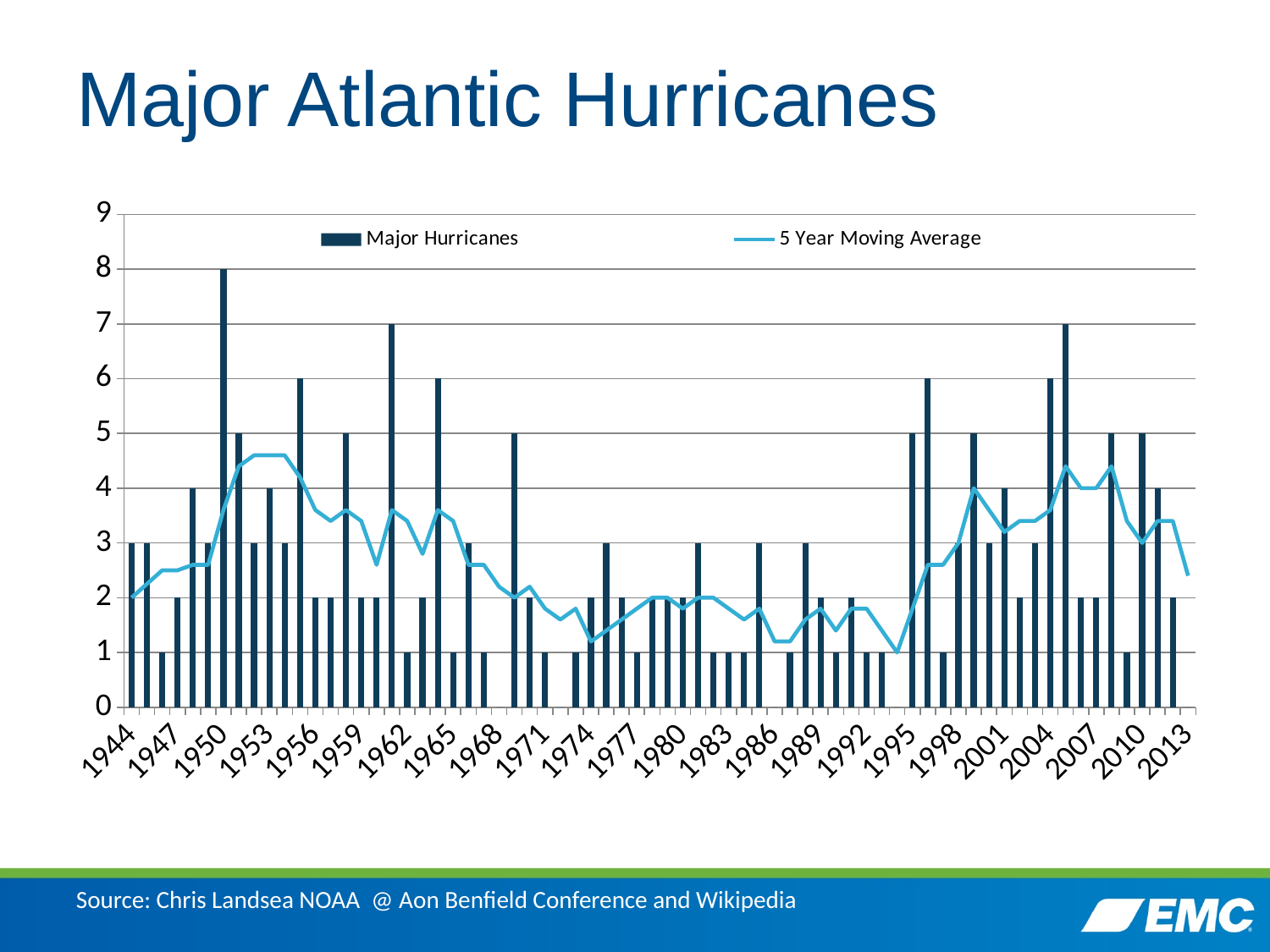
Which year has more major hurricanes, 1950 or 2004? 1950 How many major hurricanes are shown for 2004? 6 What is the difference between the number of major hurricanes in 1950 and in 2004? 2 Is the 5 Year Moving Average value for 1953 greater or less than 4? greater Is the 5 Year Moving Average value for 1986 greater or less than 2? less What kind of chart is shown on the slide? Bar chart with a line overlay How many major hurricanes are shown for 1995? 5 How many major hurricanes are shown for 1950? 8 How many series does the legend list? 2 Which year has the highest number of major hurricanes? 1950 What are the two series named in the legend? Major Hurricanes and 5 Year Moving Average Does the 5 Year Moving Average line rise or fall between 1953 and 1974? fall